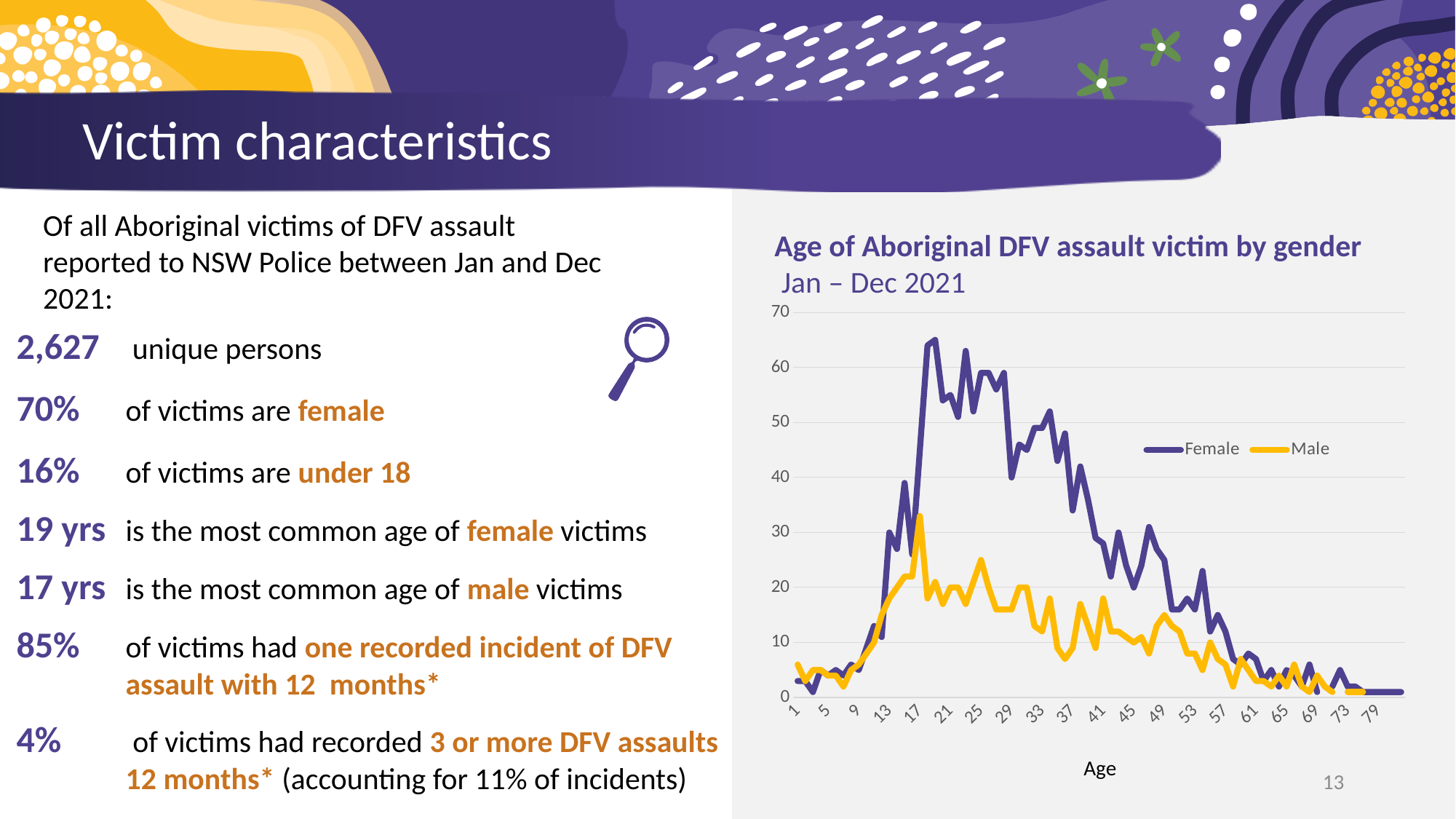
Is the Female value at age 25 greater or less than 50? greater What kind of chart is shown on the slide? line chart How many series does the chart's legend list? 2 What are the two series named in the chart's legend? Female and Male Is the peak value of the Female line greater or less than 60? greater Does the Female line generally rise or fall between age 29 and age 57? fall At age 25, which series has the larger value, Female or Male? Female Is the peak value of the Male line greater or less than 30? greater Which series reaches the higher peak value, Female or Male? Female What is the label on the chart's x axis? Age